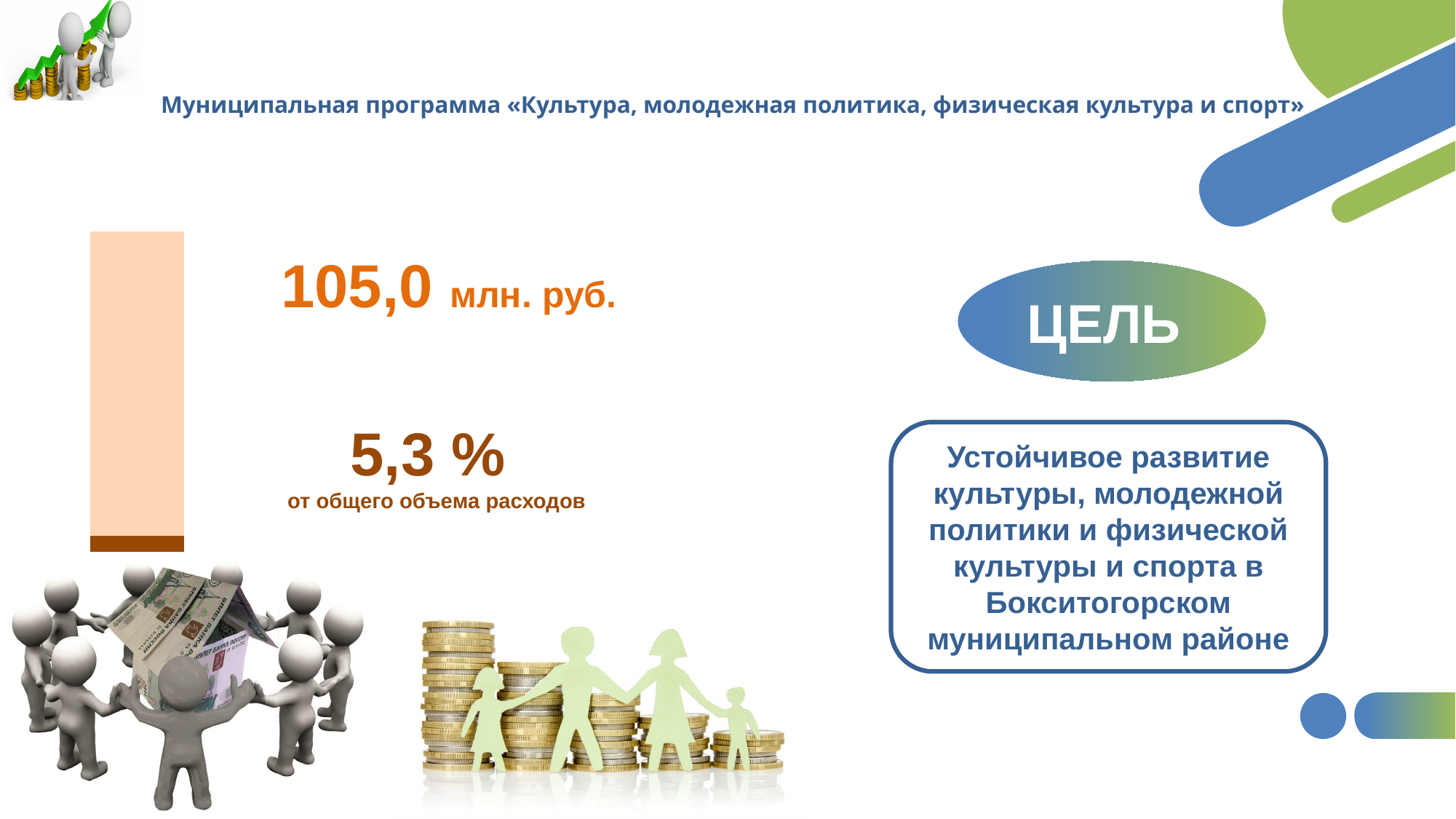
What share of total expenditure (от общего объема расходов) does the programme account for, according to the slide? 5,3 % How many segments does the stacked bar on the left of the slide have? 2 What colour is the small bottom segment of the stacked bar? brown What kind of chart is shown on the left of the slide? bar chart Is the programme's share of total expenditure greater or less than 10%? less Which segment of the stacked bar is the smallest? the brown segment at the bottom Which segment of the stacked bar is larger, the light peach segment or the brown segment? the light peach segment Does the chart on the slide display a legend? No What is the total funding amount shown for the municipal programme «Культура, молодежная политика, физическая культура и спорт»? 105,0 млн. руб.